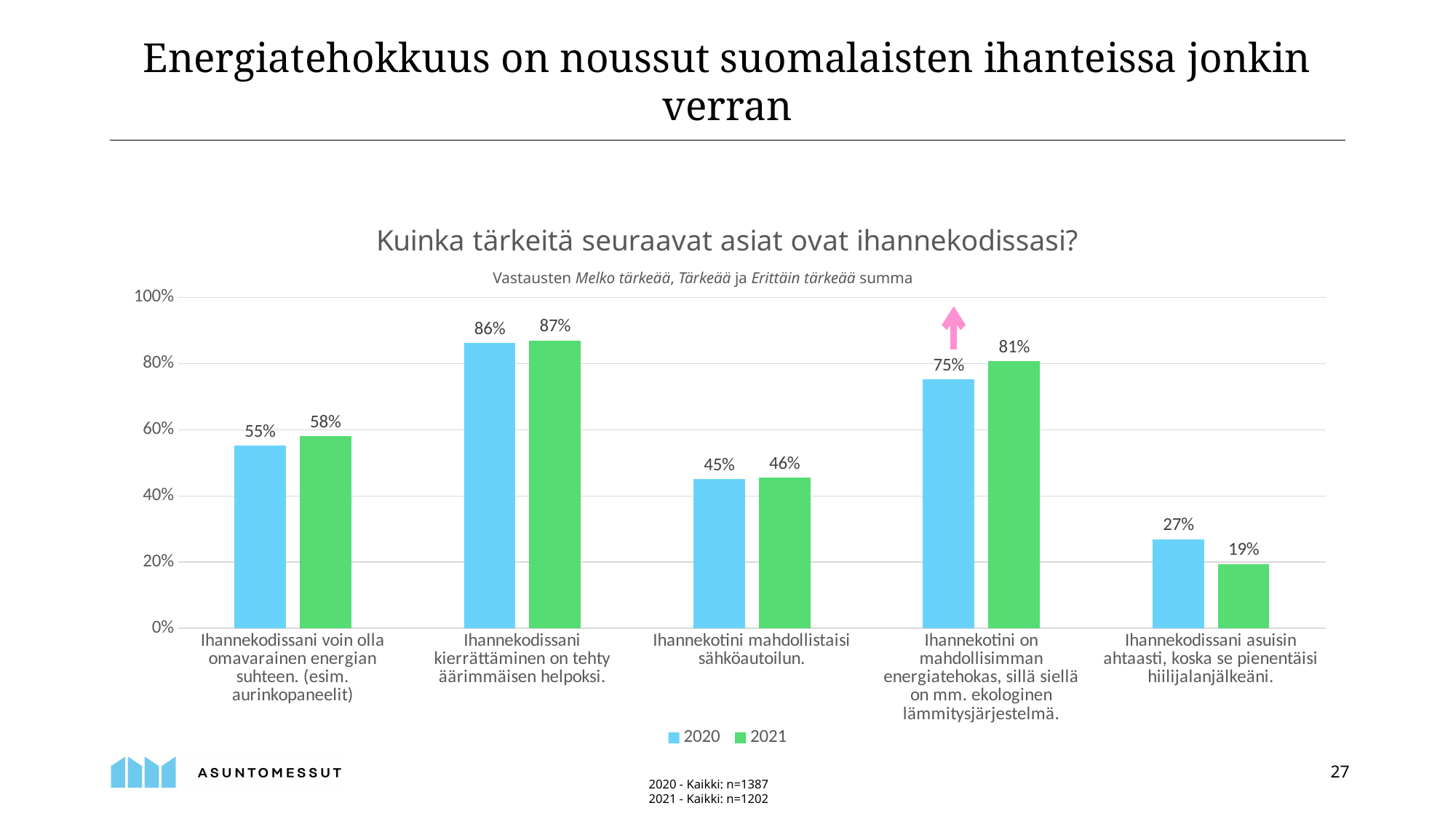
What is the 2021 value for "Ihannekodissani asuisin ahtaasti, koska se pienentäisi hiilijalanjälkeäni."? 19% Which category has the lowest 2020 value? Ihannekodissani asuisin ahtaasti, koska se pienentäisi hiilijalanjälkeäni. Is the 2020 value for "Ihannekotini mahdollistaisi sähköautoilun." greater or less than 60%? less What is the title of the chart? Kuinka tärkeitä seuraavat asiat ovat ihannekodissasi? What is the 2020 value for "Ihannekodissani voin olla omavarainen energian suhteen. (esim. aurinkopaneelit)"? 55% How many series does the legend list? 2 For "Ihannekodissani asuisin ahtaasti, koska se pienentäisi hiilijalanjälkeäni.", which year has the larger value, 2020 or 2021? 2020 What kind of chart is shown on the slide? Bar chart How many categories are shown on the x axis? 5 What is the 2021 value for "Ihannekotini on mahdollisimman energiatehokas, sillä siellä on mm. ekologinen lämmitysjärjestelmä."? 81% What is the difference between the 2021 and 2020 values for "Ihannekotini on mahdollisimman energiatehokas, sillä siellä on mm. ekologinen lämmitysjärjestelmä."? 6 percentage points Which category has the highest 2021 value? Ihannekodissani kierrättäminen on tehty äärimmäisen helpoksi.